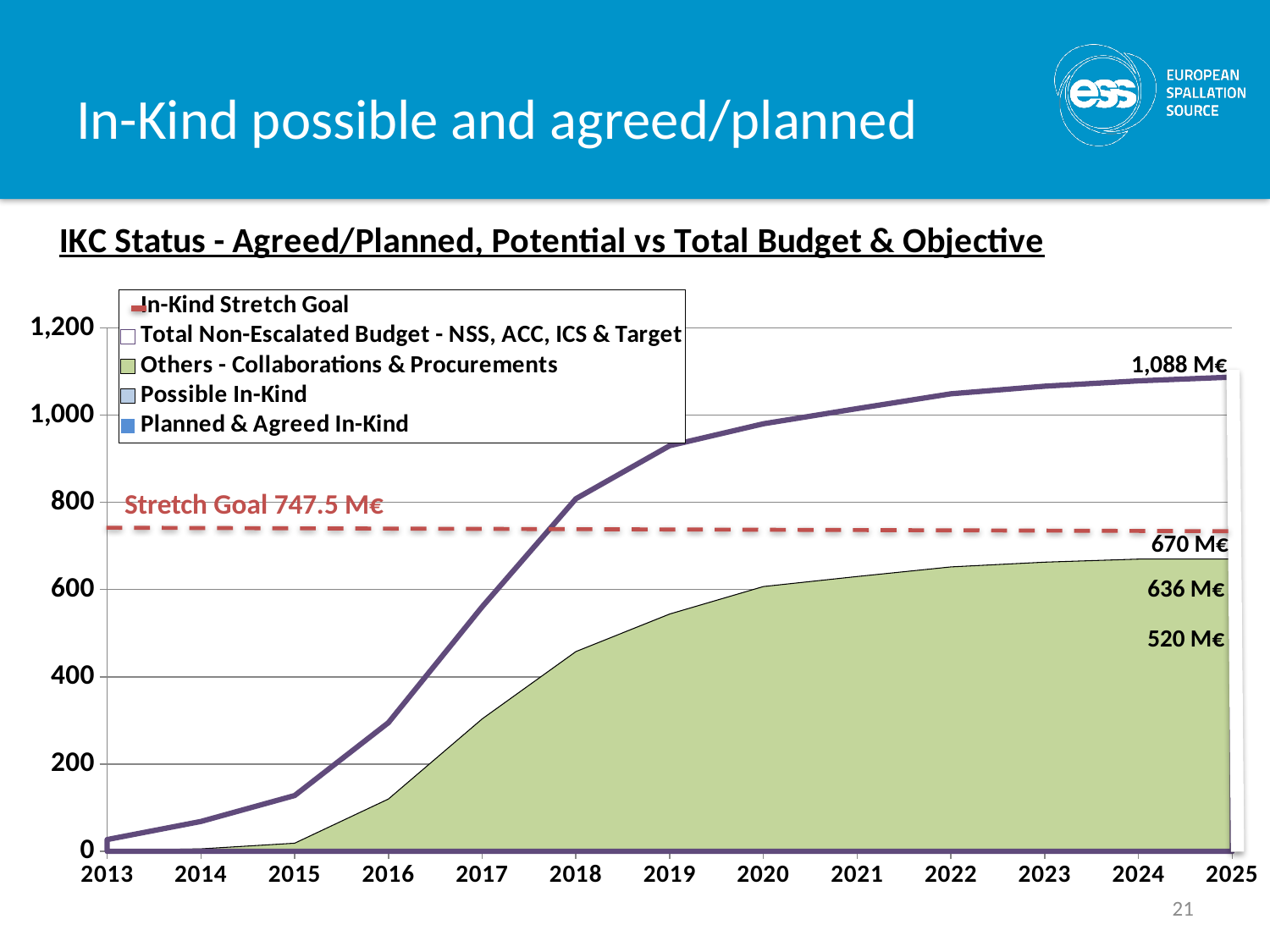
In 2017, which is larger: the Total Non-Escalated Budget line or the In-Kind Stretch Goal line? In-Kind Stretch Goal Is the value of the green Others - Collaborations & Procurements area in 2018 greater or less than 400? greater Is the Total Non-Escalated Budget in 2019 greater or less than 800? greater Does the Total Non-Escalated Budget line rise or fall from 2013 to 2025? rise Is the Total Non-Escalated Budget in 2022 greater or less than 1,000? greater What value is labelled at the top of the green shaded area in 2025? 670 M€ What is the difference between the 2025 Total Non-Escalated Budget (1,088 M€) and the Stretch Goal (747.5 M€)? 340.5 M€ What is the title of the chart? IKC Status - Agreed/Planned, Potential vs Total Budget & Objective How many series does the chart legend list? 5 How many years are shown on the x axis? 13 What value is given for the In-Kind Stretch Goal? 747.5 M€ What is the labelled value of the Total Non-Escalated Budget line in 2025? 1,088 M€